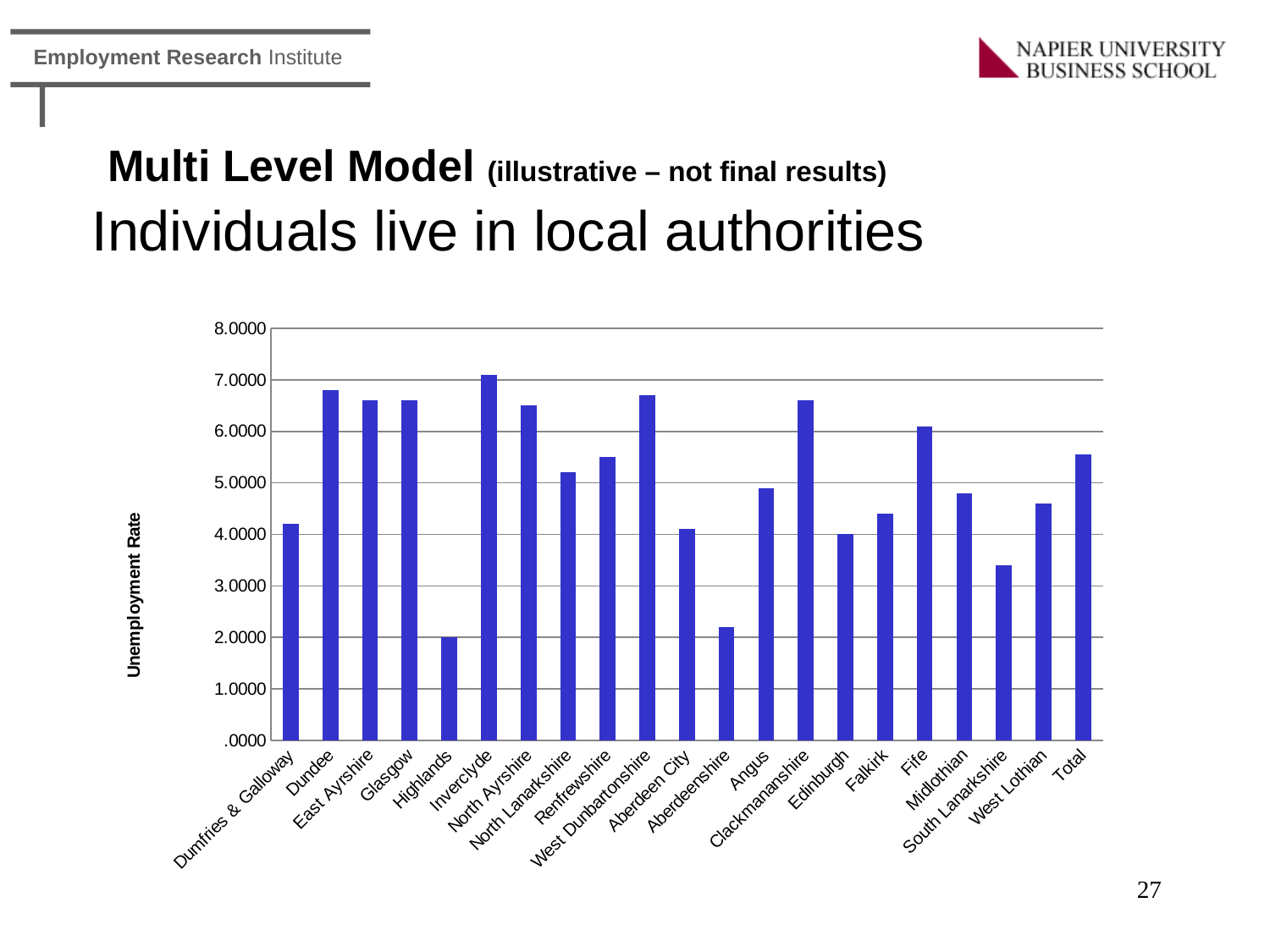
Is the value for Total greater or less than 5.0000? greater Is the value for Dundee greater or less than 6.0000? greater Is the value for Fife greater or less than 5.0000? greater Which category has the highest unemployment rate in the chart? Inverclyde What is the label of the vertical axis of the chart? Unemployment Rate What is the unemployment rate for Highlands? 2.0000 Which has a higher unemployment rate, West Dunbartonshire or Renfrewshire? West Dunbartonshire How many categories are shown along the x axis of the chart? 21 What kind of chart is shown on the slide? bar chart Which has a higher unemployment rate, Inverclyde or Dumfries & Galloway? Inverclyde